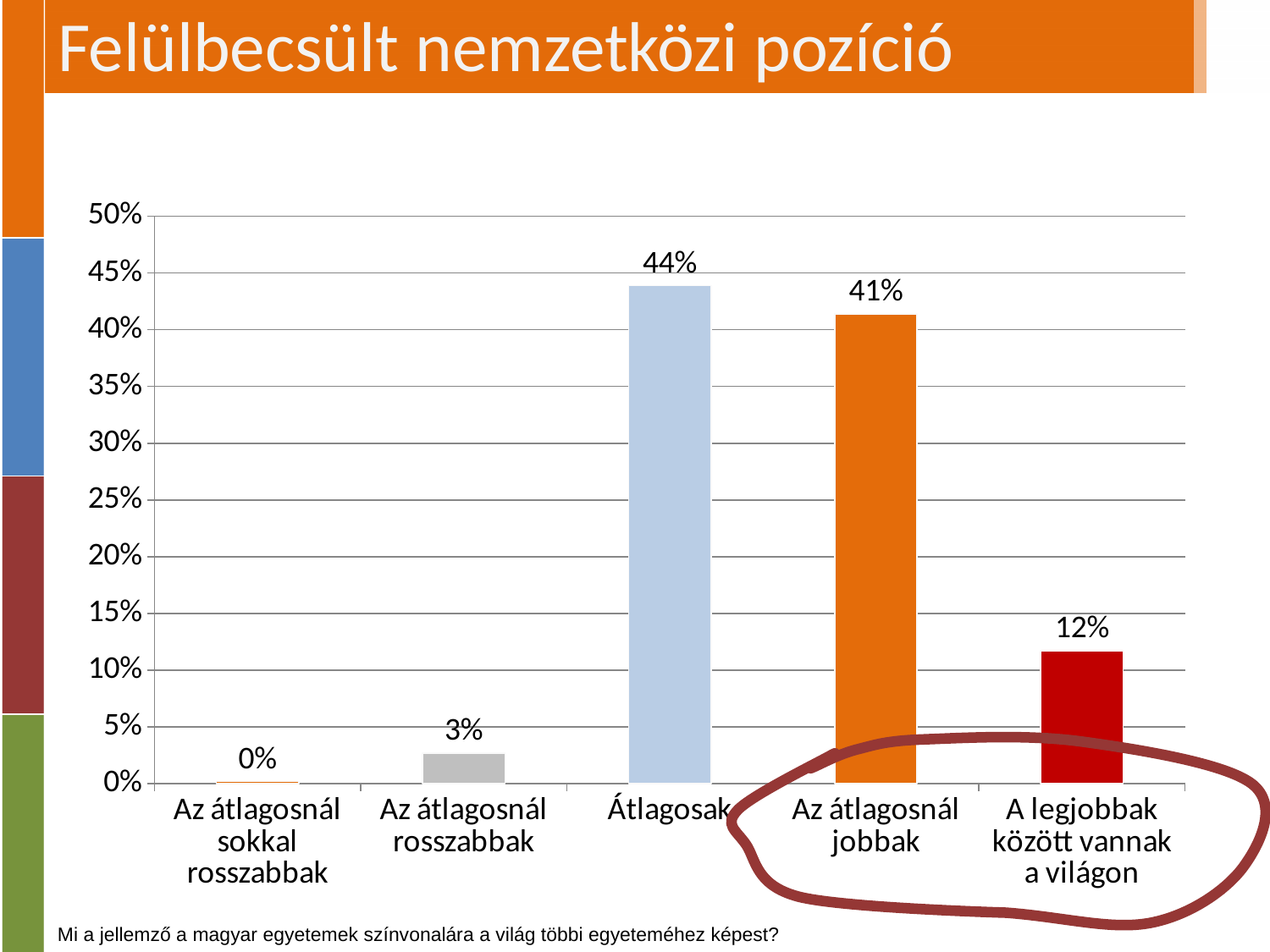
What is the value for "Az átlagosnál jobbak"? 41% What is the difference between the values for "Átlagosak" and "Az átlagosnál jobbak"? 3% How many categories are shown on the x axis? 5 Which category has the highest value? Átlagosak What is the value for "Az átlagosnál sokkal rosszabbak"? 0% What is the value for "Átlagosak"? 44% What is the difference between the values for "Az átlagosnál jobbak" and "A legjobbak között vannak a világon"? 29% What kind of chart is shown on the slide? Bar chart What is the value for "Az átlagosnál rosszabbak"? 3% Which is larger, the value for "Az átlagosnál rosszabbak" or the value for "A legjobbak között vannak a világon"? A legjobbak között vannak a világon Which category has the lowest value? Az átlagosnál sokkal rosszabbak What is the value for "A legjobbak között vannak a világon"? 12%